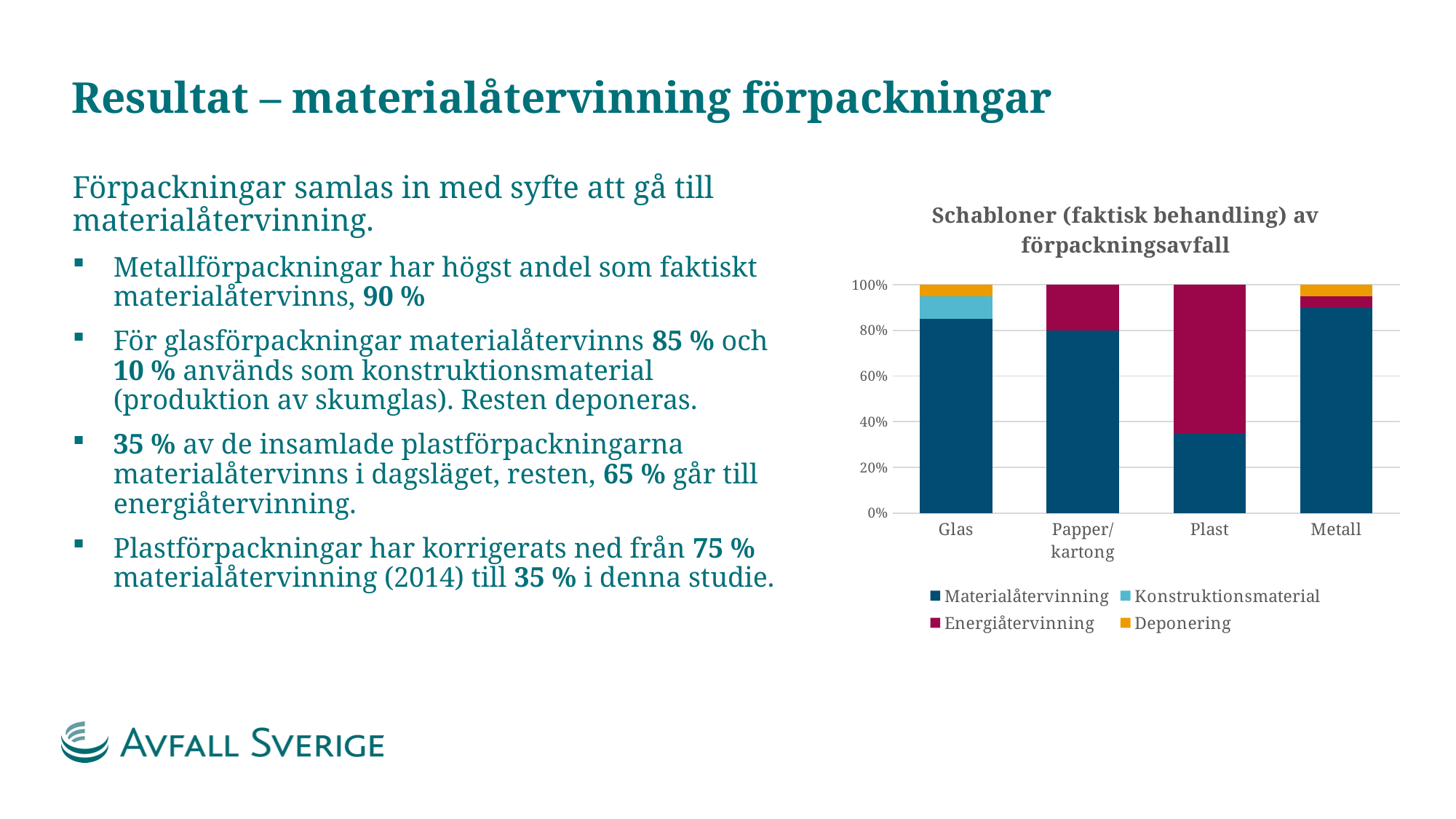
How many categories are shown on the x axis of the chart? 4 How many series does the chart legend list? 4 What is the title of the chart? Schabloner (faktisk behandling) av förpackningsavfall Is the Materialåtervinning value for Plast greater or less than 40%? less Which category has the largest Energiåtervinning share? Plast What is the Materialåtervinning value for Papper/kartong? 80% Is the Materialåtervinning value for Metall greater or less than 80%? greater What kind of chart is shown on the slide? stacked bar chart Which category has the lowest Materialåtervinning share? Plast What is the total of the stacked bar for Plast? 100% Which is larger, the Materialåtervinning share for Glas or for Plast? Glas Which category has the highest Materialåtervinning share? Metall